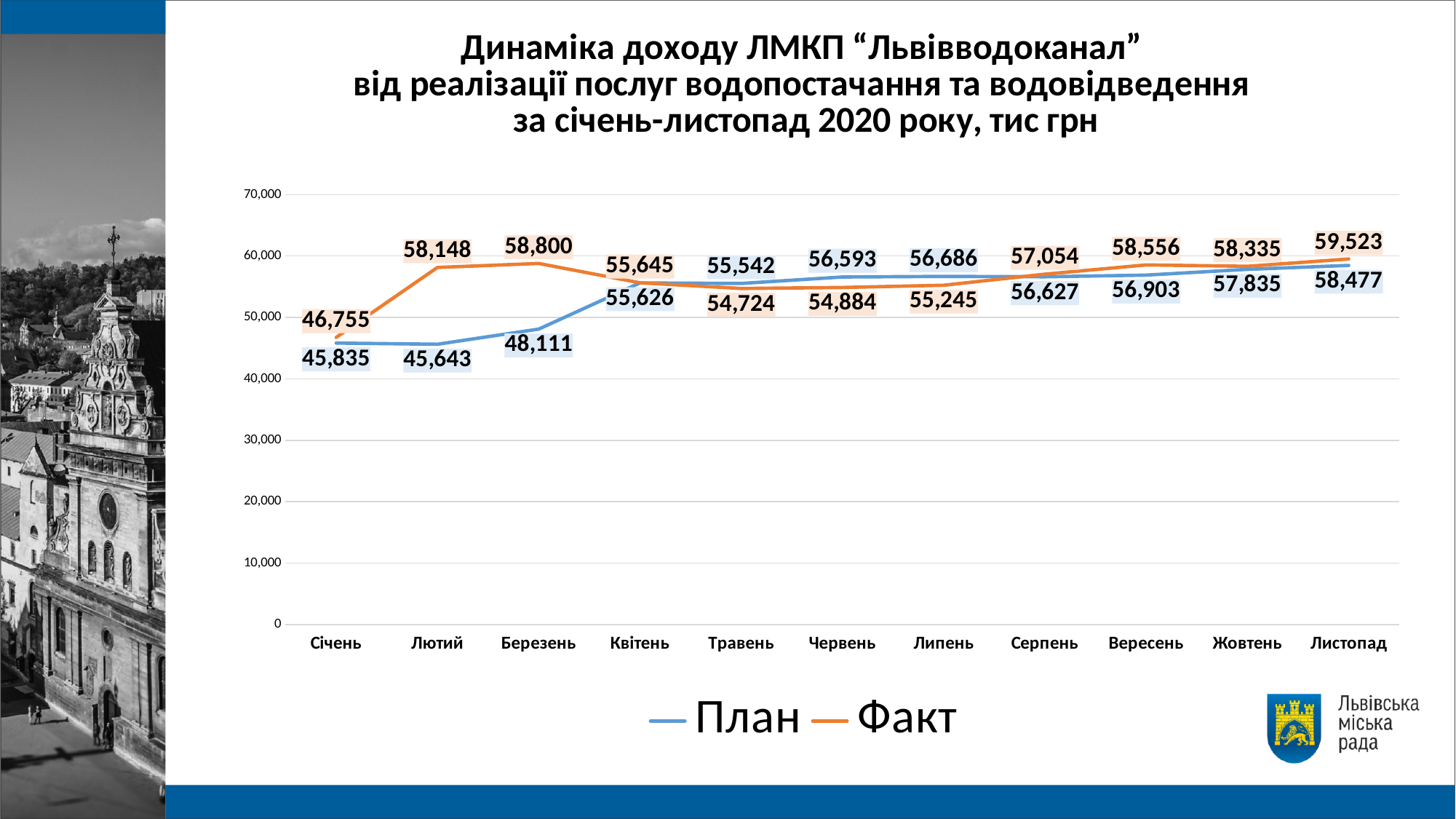
In which month is the План value lowest? Лютий What is the difference between the Факт and План values for Лютий? 12,505 In which month is the Факт value highest? Листопад What is the План value for Вересень? 56,903 How many months are shown on the x axis? 11 What is the План value for Березень? 48,111 Which is larger for Червень, the План value or the Факт value? План What kind of chart is shown on the slide? Line chart What is the Факт value for Листопад? 59,523 How many series does the legend list? 2 What is the difference between the Факт and План values for Листопад? 1,046 What is the Факт value for Лютий? 58,148